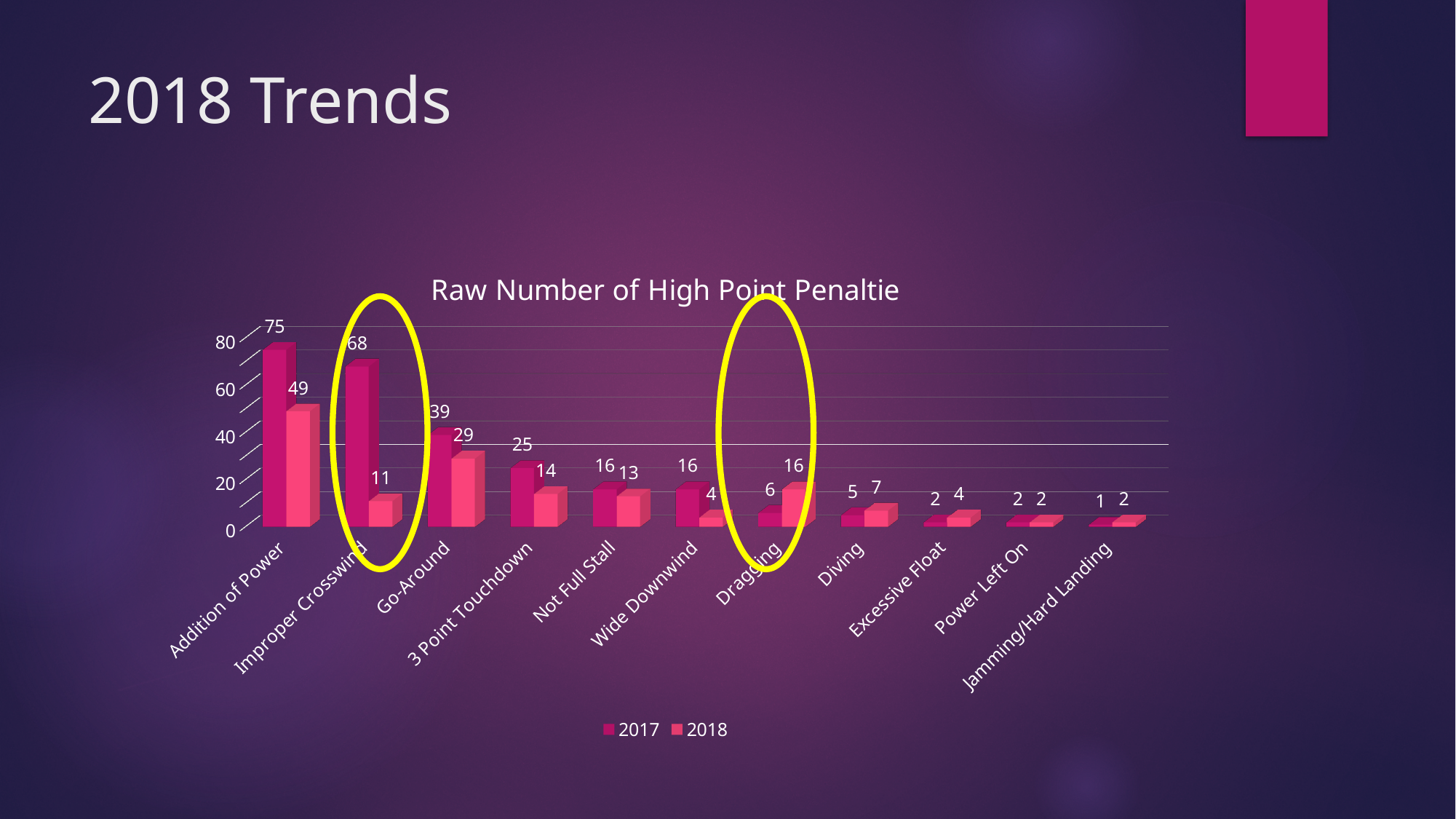
How many series does the legend list? 2 What kind of chart is shown? Bar chart What is the 2018 value for Improper Crosswind? 11 What is the 2018 value for Go-Around? 29 Which category has the highest 2017 value? Addition of Power What is the 2017 value for Dragging? 6 What is the title of the chart? Raw Number of High Point Penaltie Which category has the lowest 2017 value? Jamming/Hard Landing How many categories are shown on the x axis? 11 What is the difference between the 2017 and 2018 values for Improper Crosswind? 57 What is the 2017 value for Addition of Power? 75 Which is larger for Dragging, the 2017 value or the 2018 value? 2018